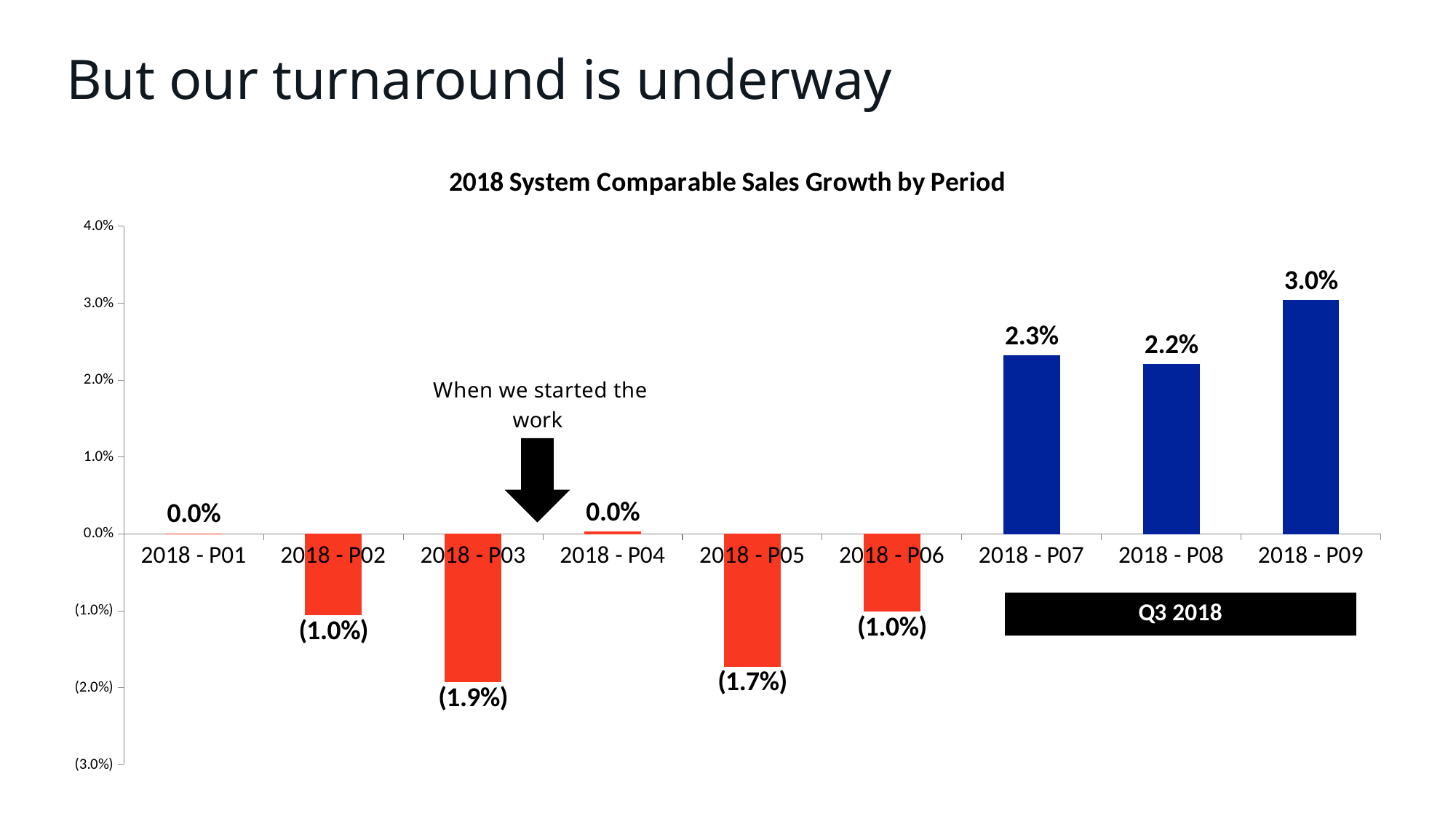
What is the value for 2018 - P09? 3.0% How many periods are shown on the x axis? 9 Which periods are grouped under the Q3 2018 label? 2018 - P07, 2018 - P08, 2018 - P09 What is the value for 2018 - P07? 2.3% Which is larger, the value for 2018 - P07 or 2018 - P08? 2018 - P07 What is the value for 2018 - P05? (1.7%) Which period has the lowest comparable sales growth? 2018 - P03 What is the difference between the values for 2018 - P09 and 2018 - P08? 0.8% What is the title of the chart? 2018 System Comparable Sales Growth by Period What kind of chart is shown on the slide? Bar chart Which period has the highest comparable sales growth? 2018 - P09 What is the value for 2018 - P03? (1.9%)